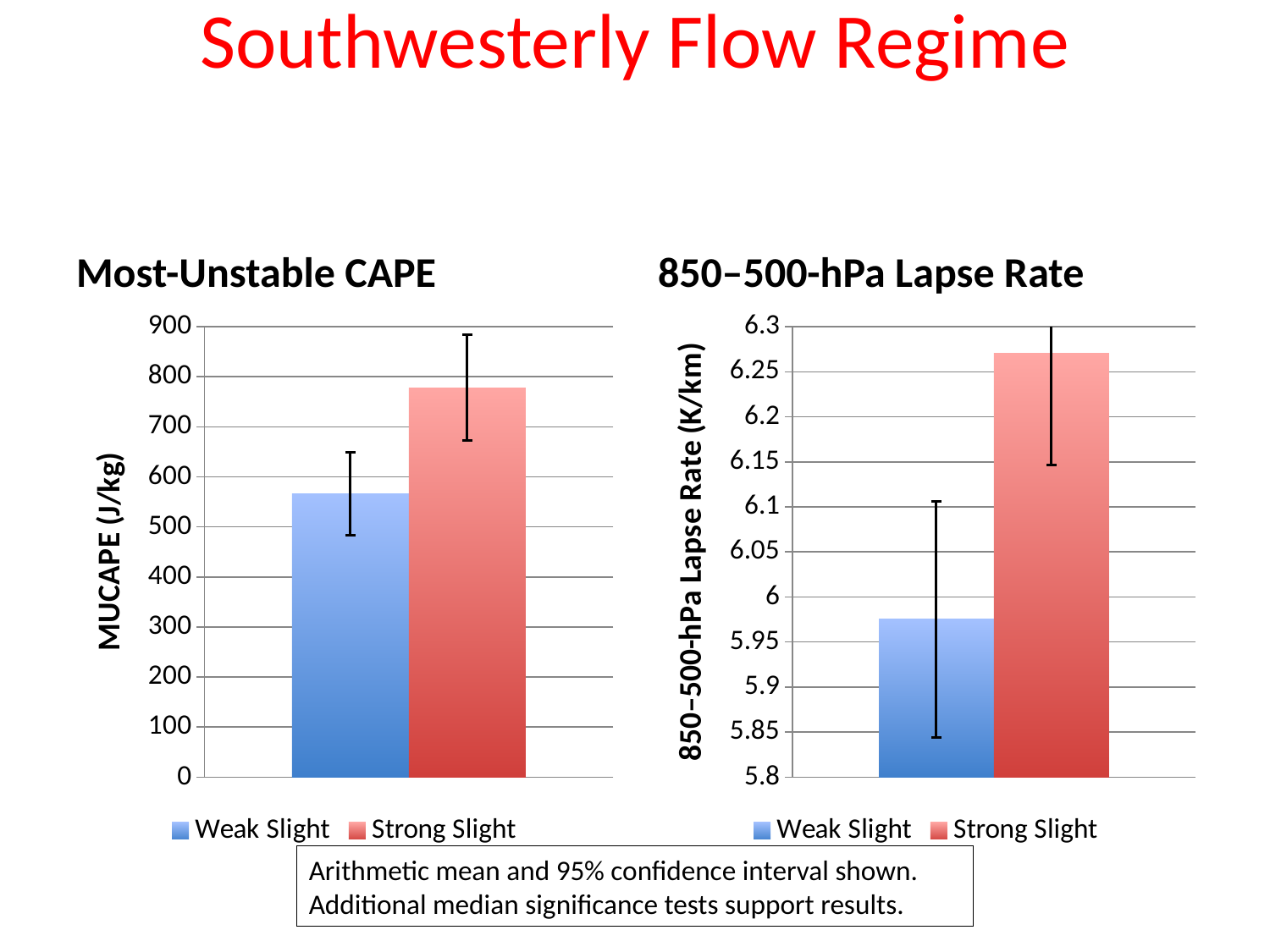
What kind of chart is the Most-Unstable CAPE chart? bar chart In the Most-Unstable CAPE chart, is the value for Weak Slight greater or less than 500? greater In the 850–500-hPa Lapse Rate chart, is the value for Strong Slight greater or less than 6.2? greater In the Most-Unstable CAPE chart, which series has the lower MUCAPE value? Weak Slight In the 850–500-hPa Lapse Rate chart, is the value for Weak Slight greater or less than 6? less In the Most-Unstable CAPE chart, which series has the higher MUCAPE value? Strong Slight How many series does the legend of the 850–500-hPa Lapse Rate chart list? 2 What is the y-axis label of the Most-Unstable CAPE chart? MUCAPE (J/kg) How many bars are plotted in the Most-Unstable CAPE chart? 2 In the 850–500-hPa Lapse Rate chart, is the Weak Slight bar or the Strong Slight bar taller? Strong Slight In the 850–500-hPa Lapse Rate chart, which series has the higher lapse rate? Strong Slight